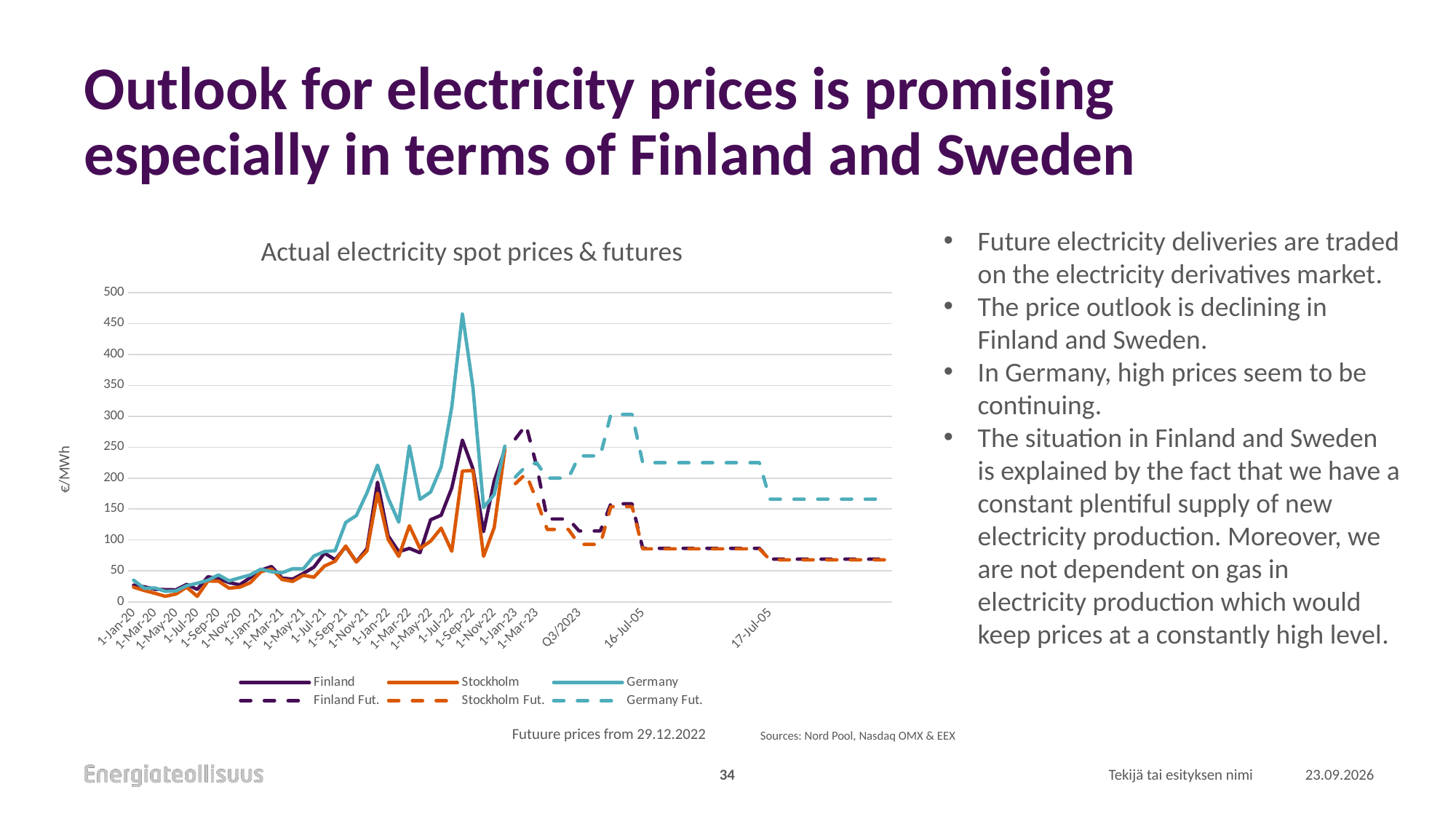
How many series does the chart legend list? 6 Is the value of the Germany Fut. series at 17-Jul-05 greater or less than 150? greater Is the highest value of the Germany Fut. series greater or less than 250? greater At 1-Sep-22, which is larger: the Germany value or the Finland value? Germany Do the Finland Fut. values generally rise or fall from 1-Mar-23 to 17-Jul-05? fall Which series reaches the highest value on the chart? Germany At 17-Jul-05, which is larger: the Germany Fut. value or the Stockholm Fut. value? Germany Fut. Is the peak value of the Germany series around 1-Sep-22 greater or less than 400? greater What is the title of the chart? Actual electricity spot prices & futures What unit is shown on the vertical axis of the chart? €/MWh What kind of chart is shown on the slide? line chart